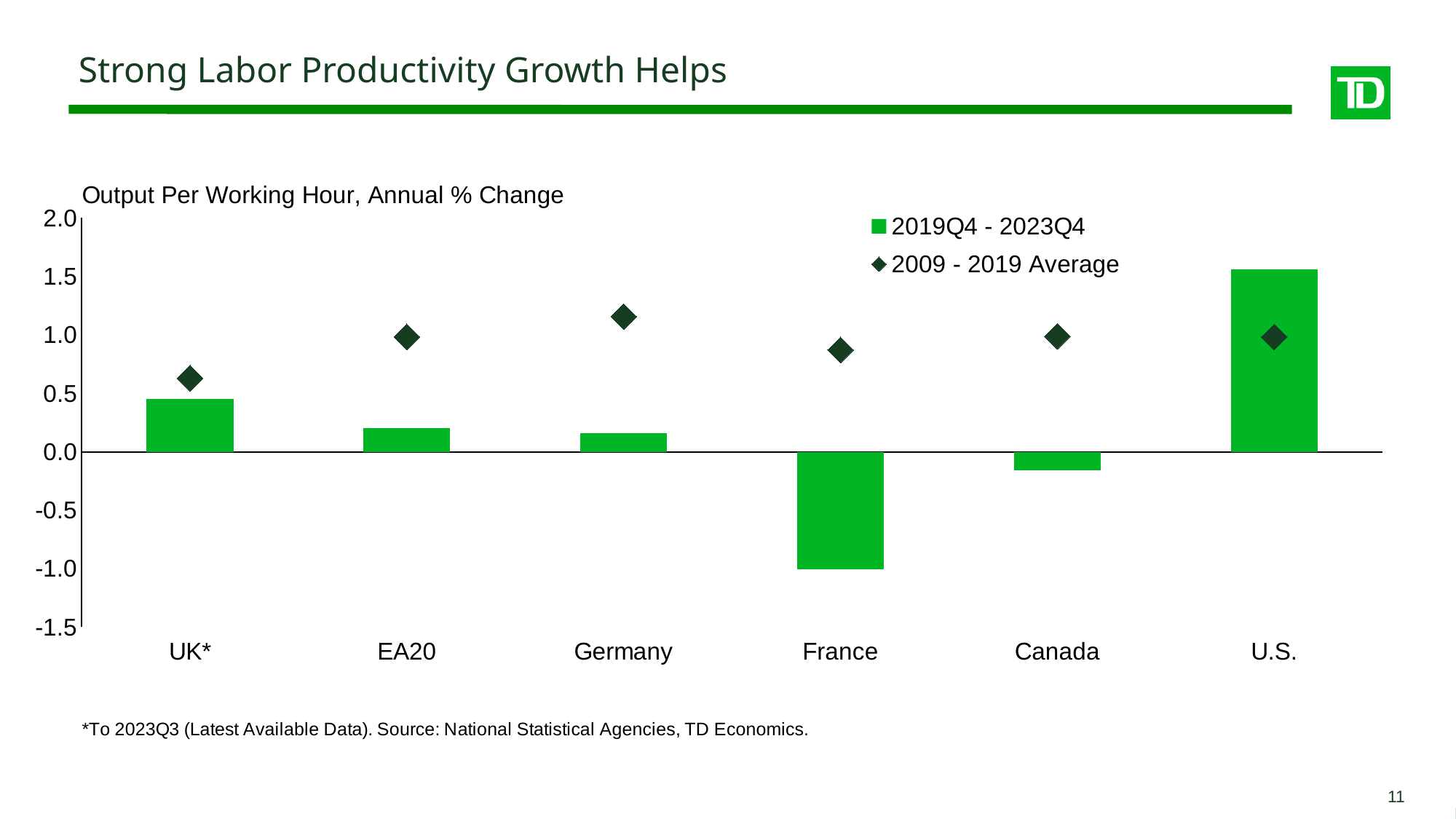
How many series does the legend list? 2 What is the title of the chart? Output Per Working Hour, Annual % Change Which has the larger 2019Q4 - 2023Q4 bar, UK* or EA20? UK* How many countries or regions are shown on the x axis? 6 Is the 2019Q4 - 2023Q4 value for France greater or less than -0.5? less Which country or region has the highest 2019Q4 - 2023Q4 bar? U.S. Which country or region has the highest 2009 - 2019 Average marker? Germany Which country or region has the lowest 2009 - 2019 Average marker? UK* What kind of chart is shown on the slide? bar chart Which country or region has the lowest 2019Q4 - 2023Q4 bar? France Is the 2019Q4 - 2023Q4 value for Canada greater or less than 0.0? less Is the 2019Q4 - 2023Q4 value for the U.S. greater or less than 1.0? greater